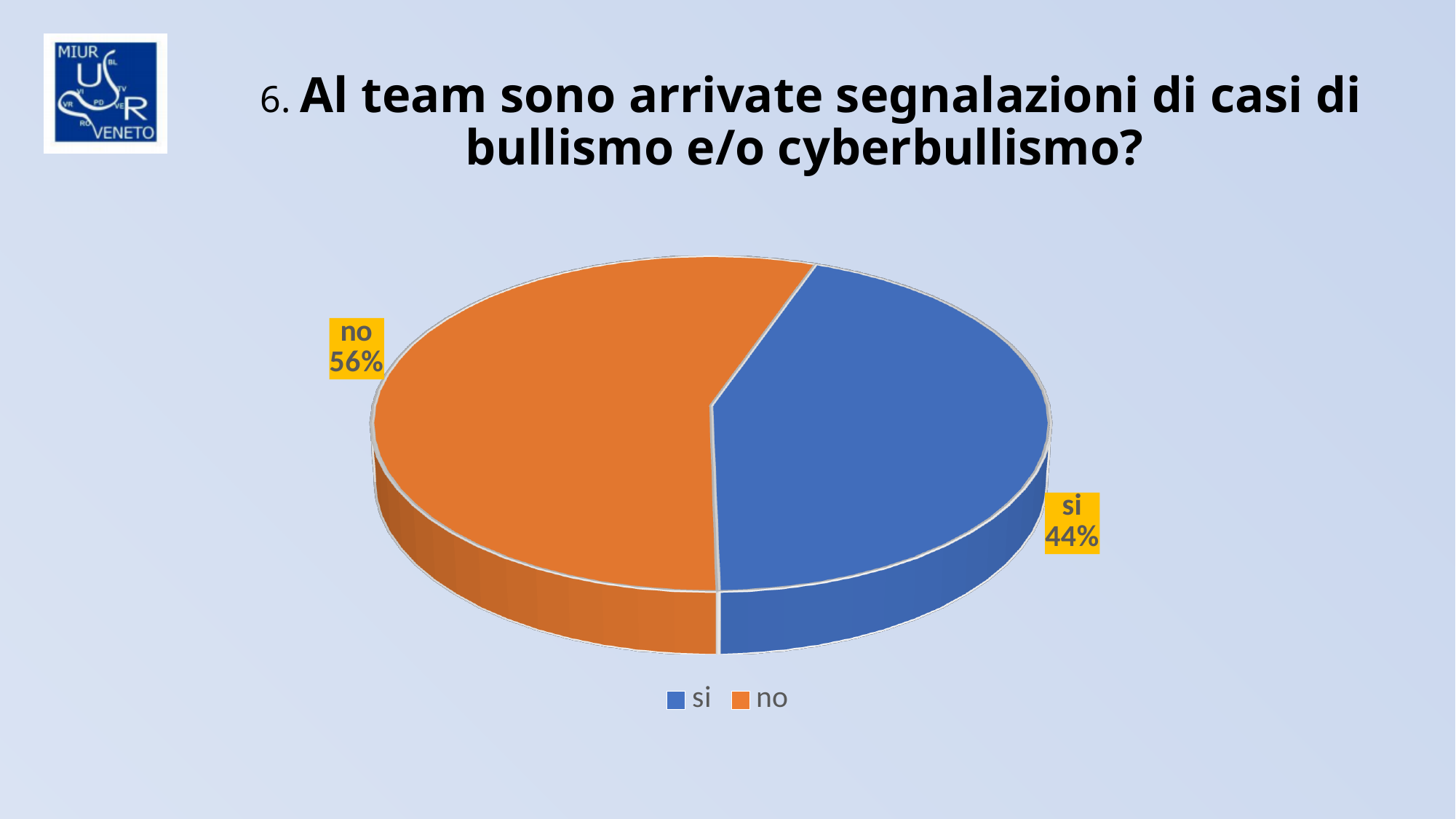
Which slice is larger, "si" or "no"? no Which slice of the pie chart is the smallest? si What percentage of the pie chart is labelled "si"? 44% What share of the pie does the "si" slice represent? 44% What percentage of the pie chart is labelled "no"? 56% What is the difference in percentage points between the "no" slice and the "si" slice? 12 What colour is the "si" slice in the pie chart? blue How many entries does the legend list? 2 What colour is the "no" slice in the pie chart? orange How many slices does the pie chart have? 2 Which slice of the pie chart is the largest? no What kind of chart is shown on the slide? pie chart